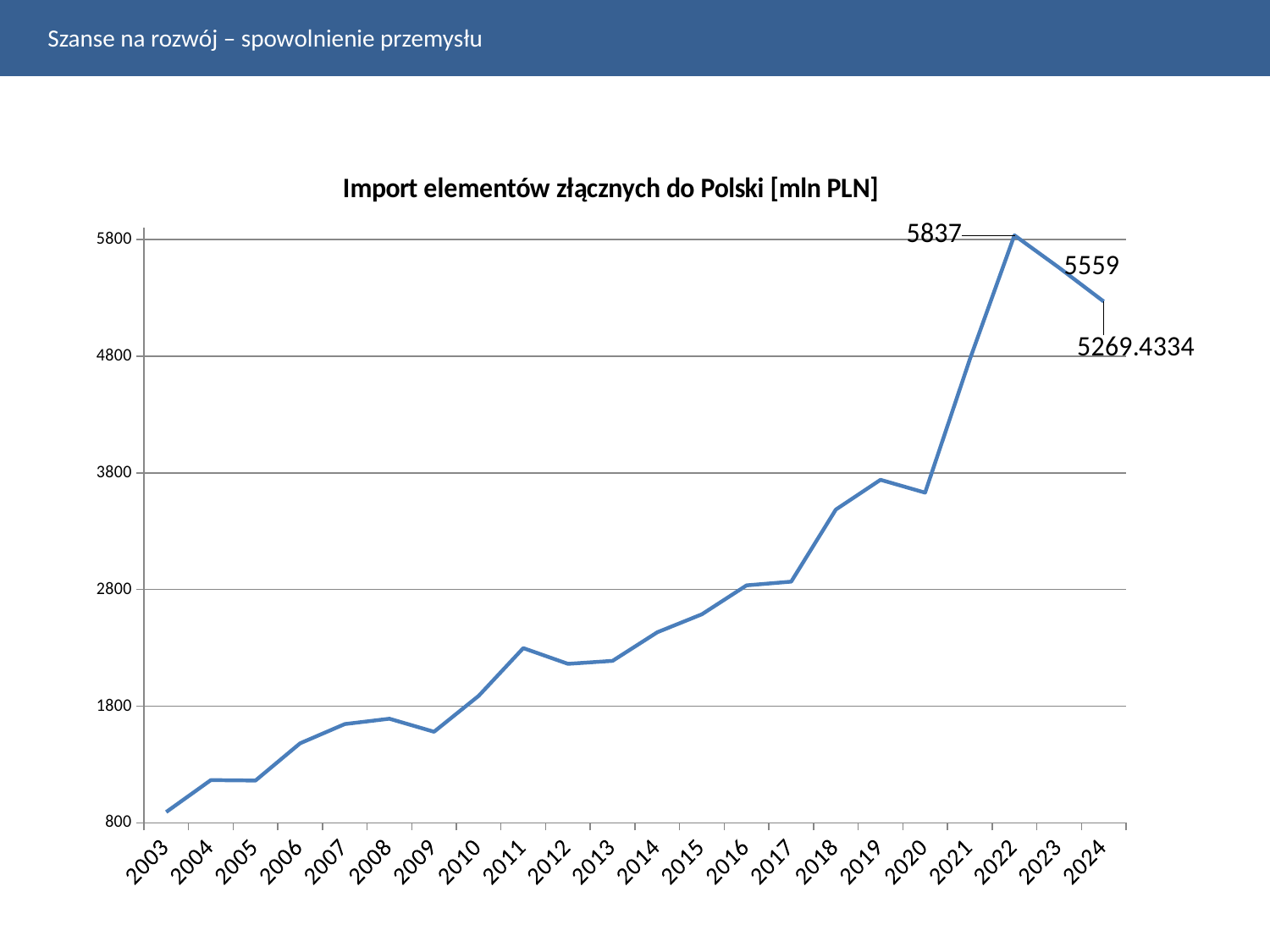
What is the title of the chart? Import elementów złącznych do Polski [mln PLN] How many years are plotted on the x axis? 22 Which year has the highest value? 2022 What is the value for 2024? 5269.4334 Is the value for 2003 greater or less than 1800? less Which year has the lowest value? 2003 What is the value for 2022? 5837 What type of chart is shown on the slide? line chart Is the value for 2018 greater or less than 2800? greater Which is larger, the value for 2023 or the value for 2024? 2023 What is the value for 2023? 5559 What is the difference between the values for 2022 and 2023? 278